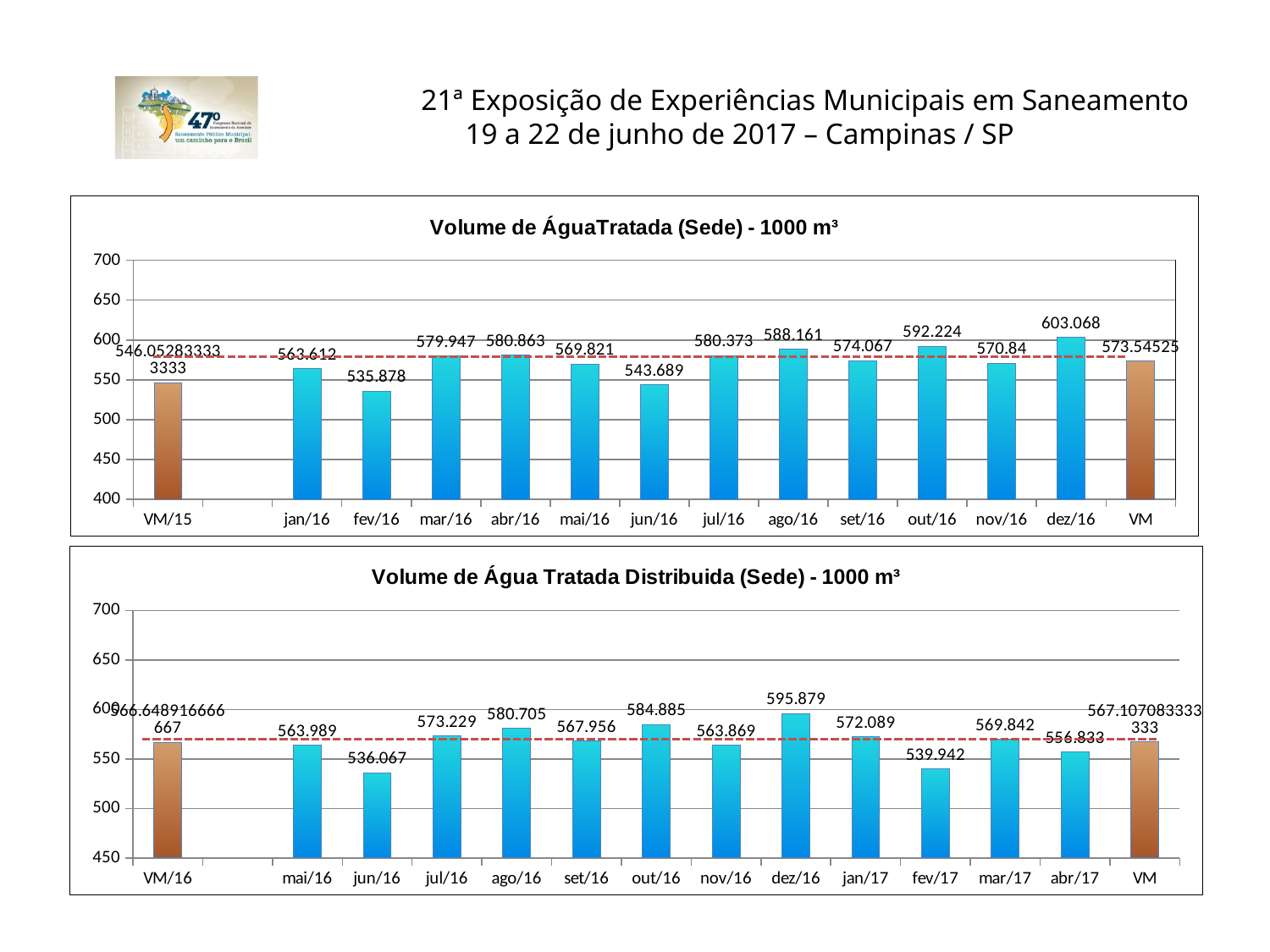
In the bottom chart (Volume de Água Tratada Distribuida), is the value for fev/17 greater or less than 550? less In the bottom chart (Volume de Água Tratada Distribuida), what is the value for dez/16? 595.879 In the top chart (Volume de ÁguaTratada), which month has the lowest value? fev/16 In the bottom chart (Volume de Água Tratada Distribuida), which month has the lowest value? jun/16 What type of chart is the top chart (Volume de ÁguaTratada)? Bar chart In the top chart (Volume de ÁguaTratada), what is the value for fev/16? 535.878 In the top chart (Volume de ÁguaTratada), what is the difference between the values for dez/16 and fev/16? 67.19 In the top chart (Volume de ÁguaTratada), which month has the highest value? dez/16 In the top chart (Volume de ÁguaTratada), which is larger, the value for out/16 or the value for set/16? out/16 How many bars are plotted in the bottom chart (Volume de Água Tratada Distribuida)? 14 In the top chart (Volume de ÁguaTratada), what is the value for dez/16? 603.068 In the bottom chart (Volume de Água Tratada Distribuida), what is the difference between the values for dez/16 and jun/16? 59.812